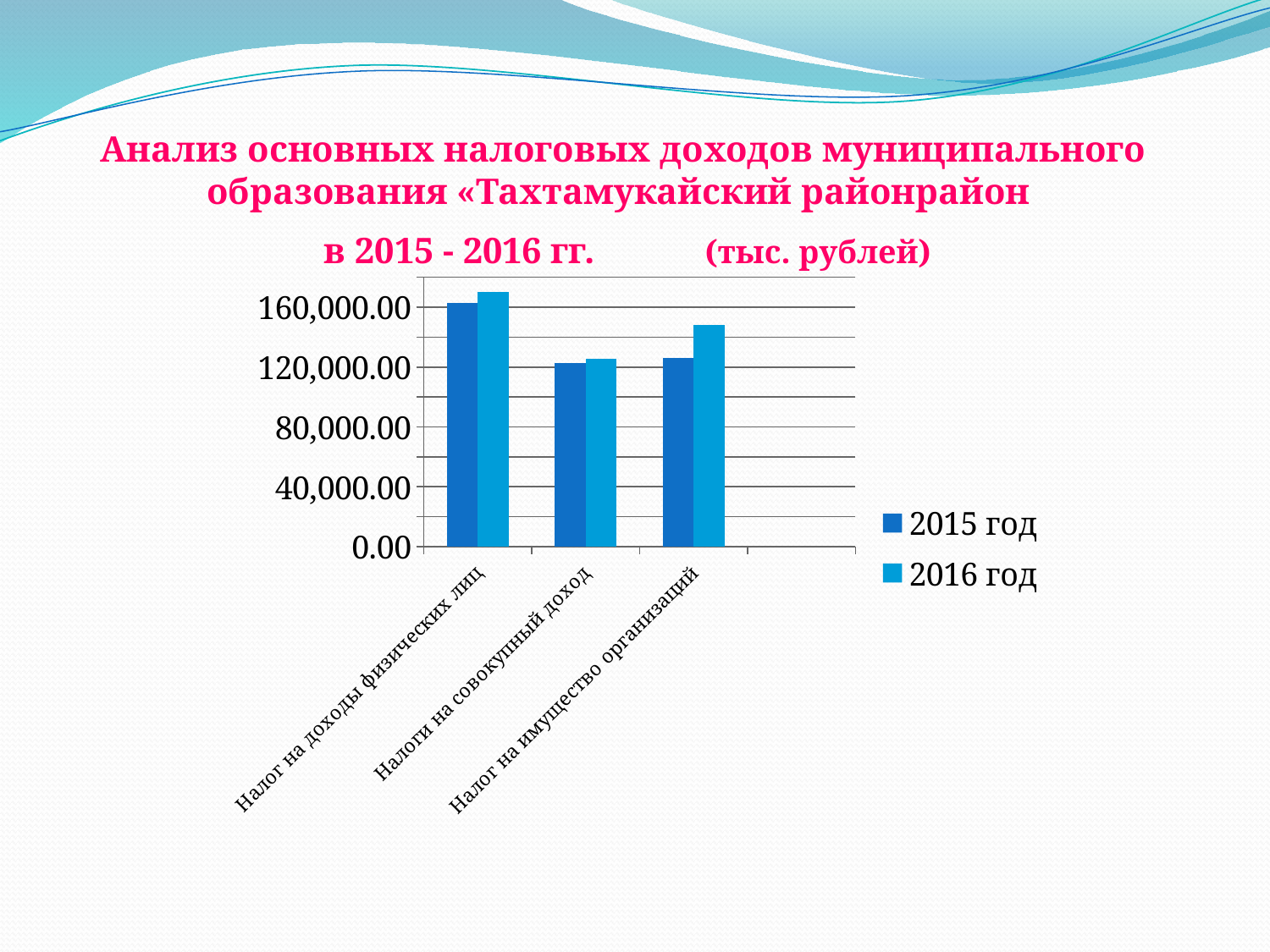
Which category has the highest value for 2016 год? Налог на доходы физических лиц Is the 2016 год value for Налоги на совокупный доход greater or less than 160,000.00? less Which category has the lowest value for 2016 год? Налоги на совокупный доход How many tax categories are shown on the x axis of the chart? 3 For Налог на имущество организаций, which year has the larger value, 2015 год or 2016 год? 2016 год Is the 2016 год value for Налог на имущество организаций greater or less than 160,000.00? less For 2016 год, which is larger: Налог на имущество организаций or Налоги на совокупный доход? Налог на имущество организаций What are the two series listed in the chart legend? 2015 год and 2016 год Is the 2016 год value for Налог на доходы физических лиц greater or less than 160,000.00? greater In what units are the values on the chart given, according to the title? тыс. рублей How many series does the chart legend list? 2 What kind of chart is shown on the slide? bar chart